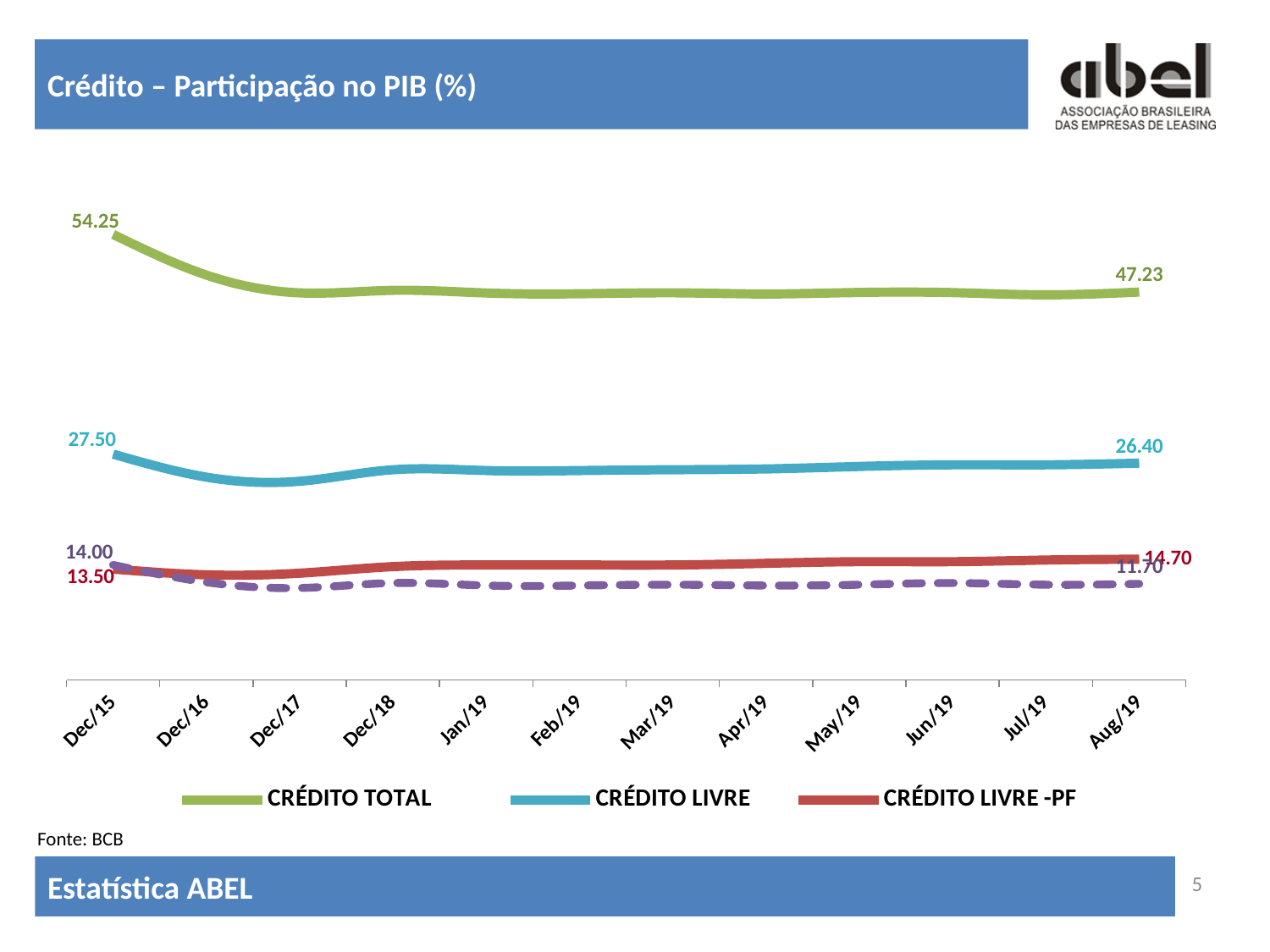
What kind of chart is shown on the slide? line chart What is the value of CRÉDITO TOTAL at Dec/15? 54.25 How many series does the legend list? 3 Which is larger at Aug/19, CRÉDITO TOTAL or CRÉDITO LIVRE? CRÉDITO TOTAL What is the value of CRÉDITO LIVRE -PF at Aug/19? 14.70 How many points are shown on the x axis? 12 Does the CRÉDITO TOTAL line rise or fall from Dec/15 to Aug/19? fall What is the difference between the CRÉDITO LIVRE values at Dec/15 and Aug/19? 1.10 What is the value of CRÉDITO TOTAL at Aug/19? 47.23 By how much did CRÉDITO TOTAL fall from Dec/15 to Aug/19? 7.02 What is the value of CRÉDITO LIVRE at Aug/19? 26.40 What is the value of CRÉDITO LIVRE at Dec/15? 27.50